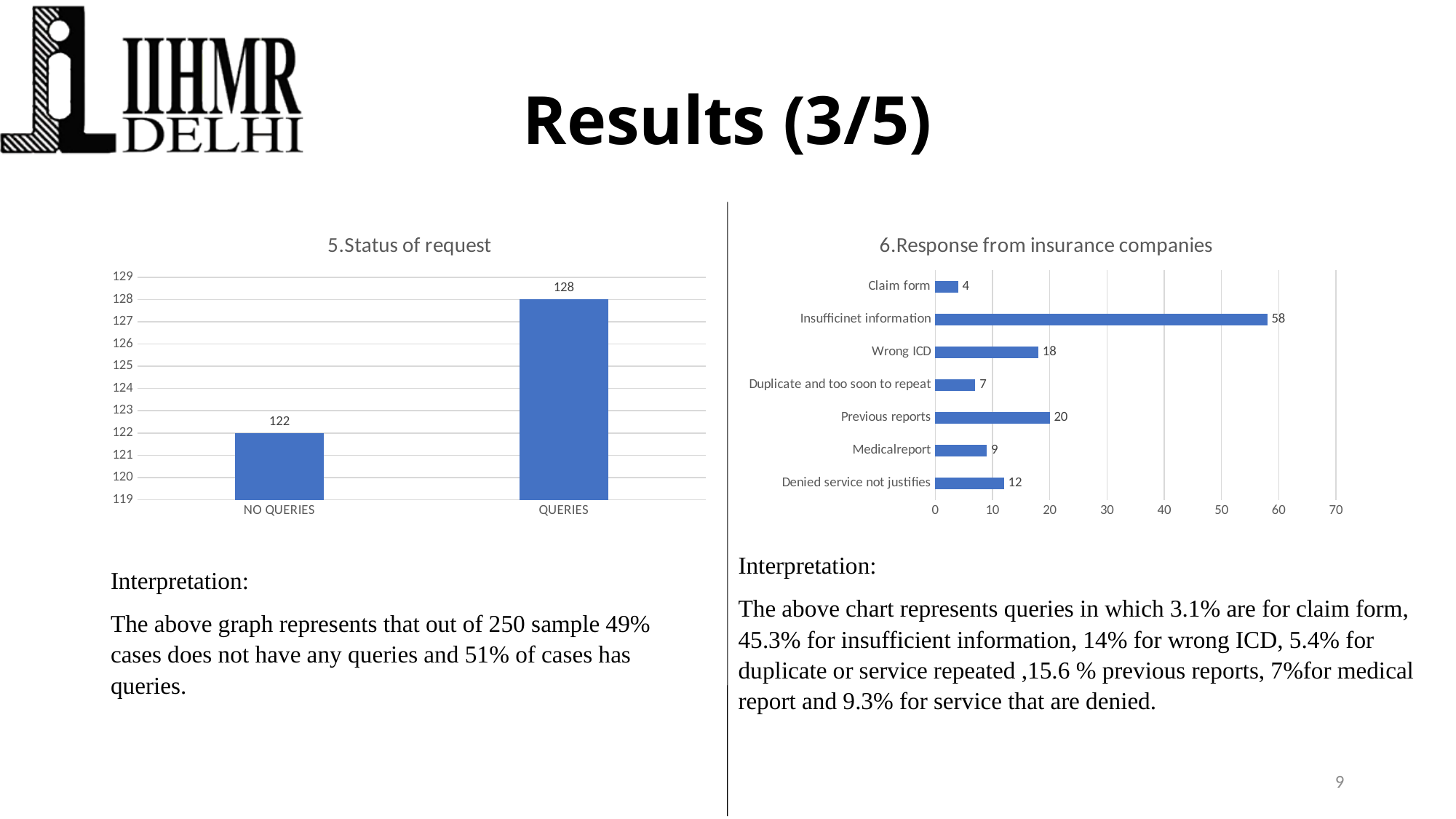
In the chart '6.Response from insurance companies', which is larger: Medicalreport or Denied service not justifies? Denied service not justifies In the chart '5.Status of request', what is the value for NO QUERIES? 122 In the chart '6.Response from insurance companies', which category has the lowest value? Claim form In the chart '6.Response from insurance companies', what is the difference between Insufficinet information and Previous reports? 38 In the chart '5.Status of request', how many categories are shown? 2 In the chart '5.Status of request', what is the value for QUERIES? 128 In the chart '5.Status of request', what is the difference between QUERIES and NO QUERIES? 6 In the chart '6.Response from insurance companies', what is the value for Previous reports? 20 What kind of chart is '5.Status of request'? Bar chart In the chart '6.Response from insurance companies', what is the value for Wrong ICD? 18 In the chart '6.Response from insurance companies', which category has the highest value? Insufficinet information In the chart '6.Response from insurance companies', how many categories are shown? 7